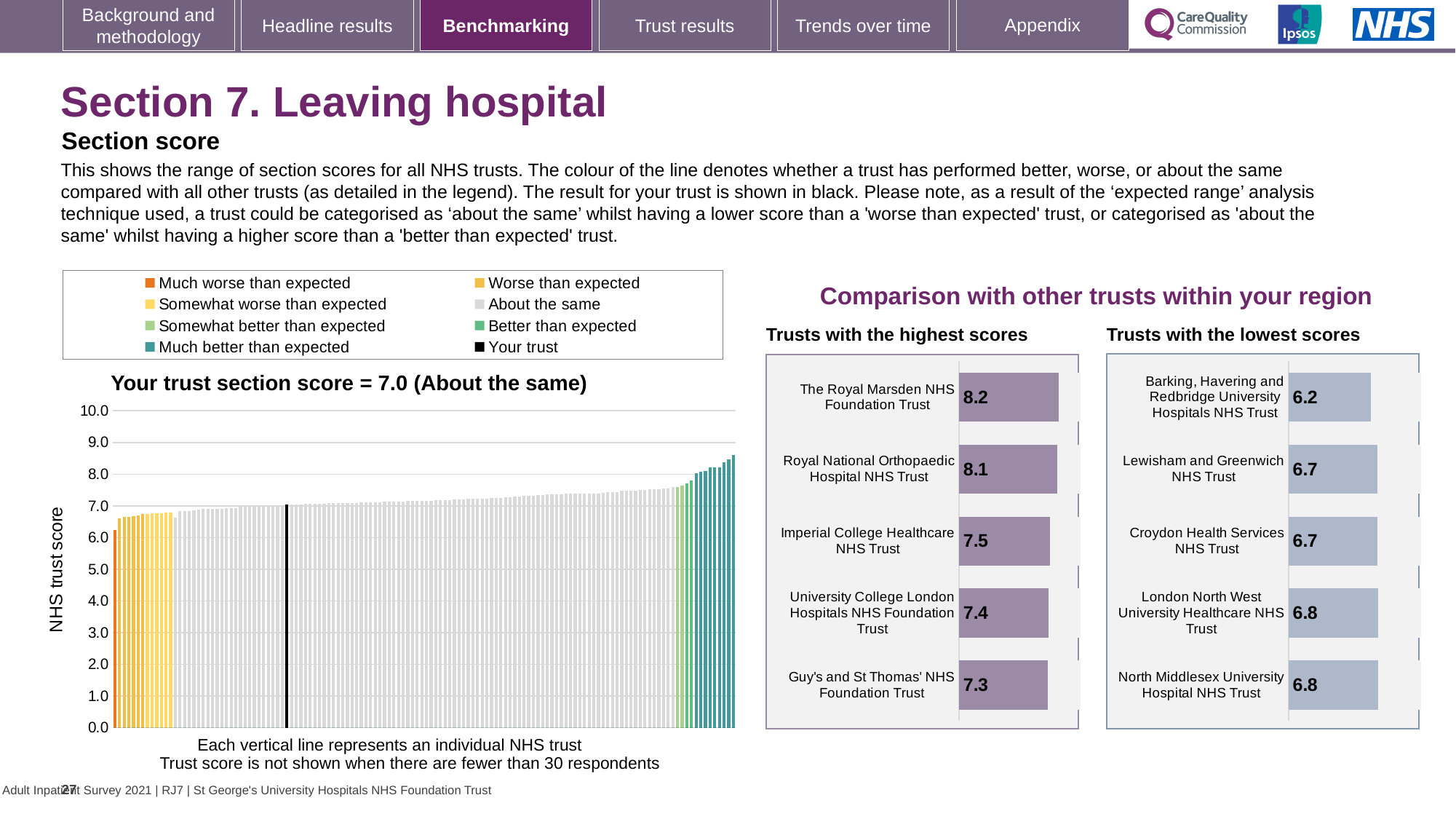
In the 'Trusts with the lowest scores' chart, which has the higher score: Lewisham and Greenwich NHS Trust or London North West University Healthcare NHS Trust? London North West University Healthcare NHS Trust In the main 'Your trust section score' chart, what is the section score for your trust? 7.0 In the 'Trusts with the highest scores' chart, which trust has the lowest score? Guy's and St Thomas' NHS Foundation Trust In the 'Trusts with the lowest scores' chart, what is the score for Barking, Havering and Redbridge University Hospitals NHS Trust? 6.2 In the 'Trusts with the highest scores' chart, what is the score for Guy's and St Thomas' NHS Foundation Trust? 7.3 In the 'Trusts with the lowest scores' chart, what is the difference between the scores of North Middlesex University Hospital NHS Trust and Barking, Havering and Redbridge University Hospitals NHS Trust? 0.6 In the 'Trusts with the highest scores' chart, what is the difference between the scores of The Royal Marsden NHS Foundation Trust and Guy's and St Thomas' NHS Foundation Trust? 0.9 In the 'Trusts with the highest scores' chart, what is the score for The Royal Marsden NHS Foundation Trust? 8.2 In the main 'Your trust section score' chart, is the value of the lowest (leftmost) bar greater or less than 7.0? less In the 'Trusts with the highest scores' chart, how many trusts are shown? 5 In the 'Trusts with the lowest scores' chart, which trust has the lowest score? Barking, Havering and Redbridge University Hospitals NHS Trust What kind of chart is the main 'Your trust section score' chart? bar chart